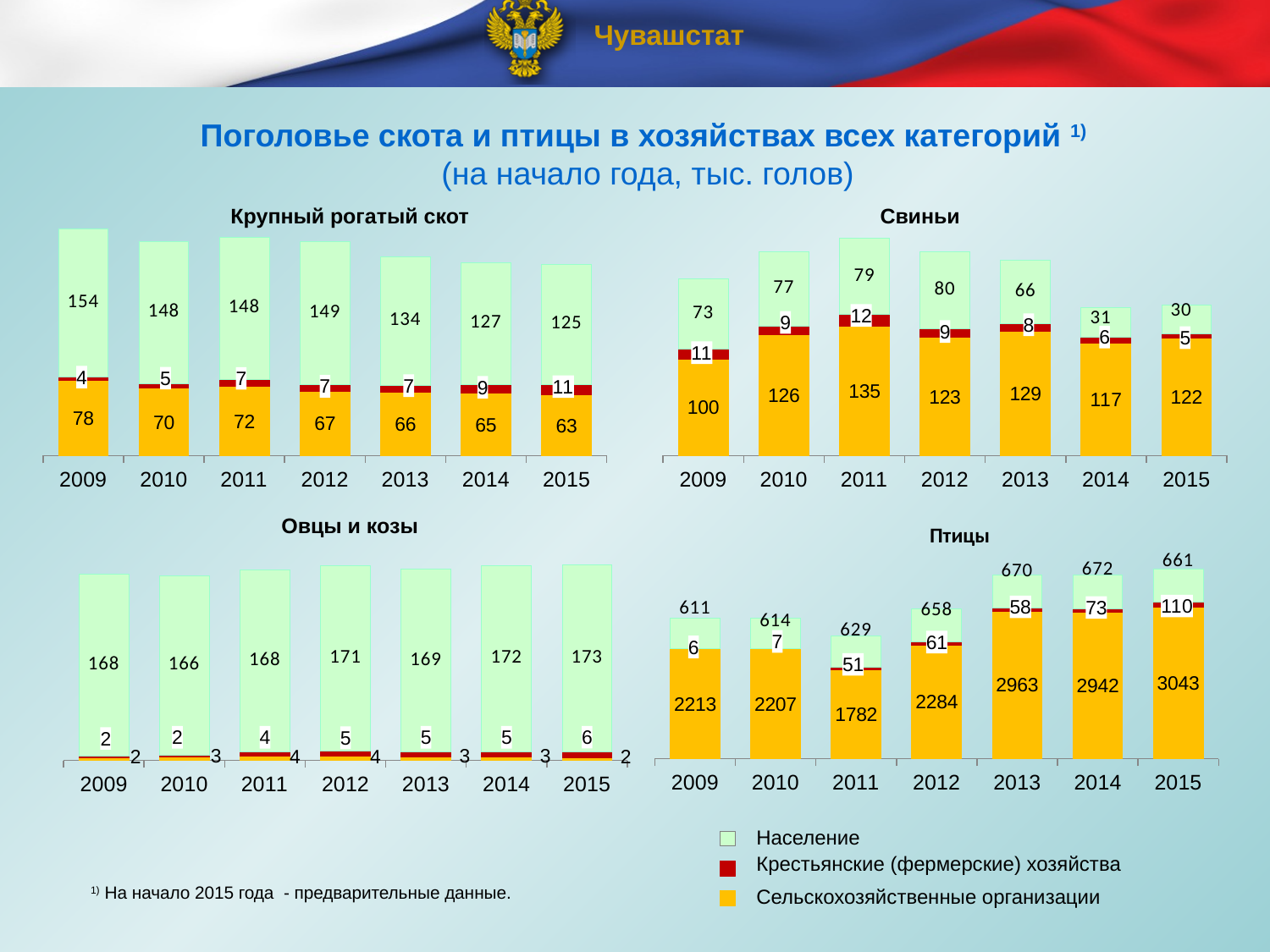
In the 'Птицы' chart, which year has the highest value for Сельскохозяйственные организации? 2015 In the 'Свиньи' chart, what is the value for Сельскохозяйственные организации in 2011? 135 In the 'Крупный рогатый скот' chart, what is the difference between the Сельскохозяйственные организации values for 2009 and 2015? 15 How many series does the legend list? 3 In the 'Свиньи' chart, which year has the lowest value for Население? 2015 In the 'Птицы' chart, what is the value for Крестьянские (фермерские) хозяйства in 2015? 110 How many years are shown on the x axis of the 'Свиньи' chart? 7 In the 'Овцы и козы' chart, which is larger: the Население value for 2015 or for 2010? 2015 What kind of chart is the 'Птицы' chart? stacked bar chart In the 'Крупный рогатый скот' chart, does the Население value rise or fall from 2012 to 2015? fall In the 'Свиньи' chart, what is the total of the stacked bar for 2015? 157 In the 'Крупный рогатый скот' chart, what is the value for Население in 2009? 154